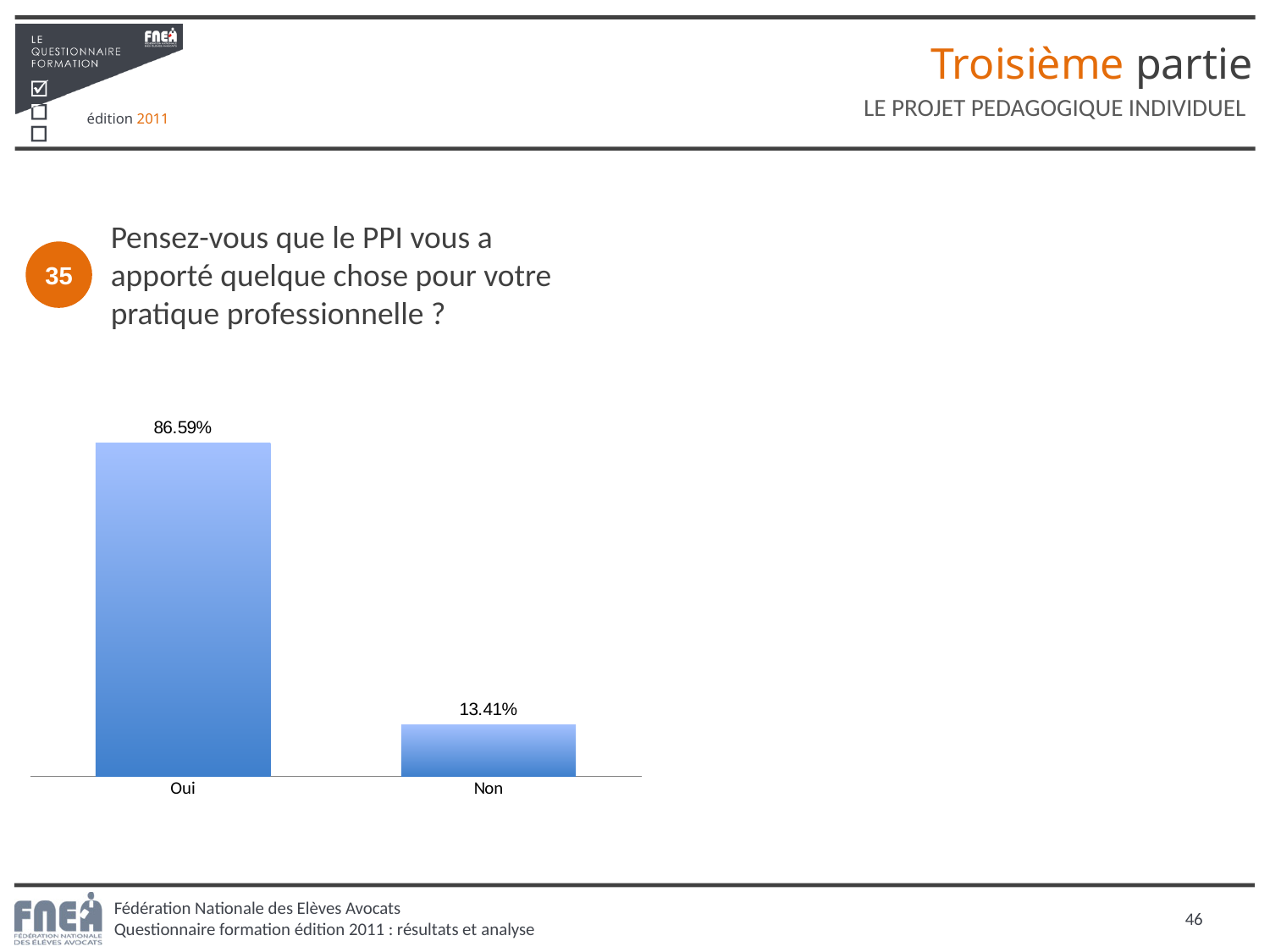
What is the question number shown next to the chart's question text? 35 Which category has the highest value? Oui What is the difference between the values for Oui and Non? 73.18% What kind of chart is shown on the slide? bar chart What is the value for Oui? 86.59% Which is larger, the value for Oui or the value for Non? Oui What survey question does the chart on the slide relate to? Pensez-vous que le PPI vous a apporté quelque chose pour votre pratique professionnelle ? How many categories are shown in the chart? 2 What is the total of the two values shown in the chart? 100% What is the value for Non? 13.41% Which category has the lowest value? Non